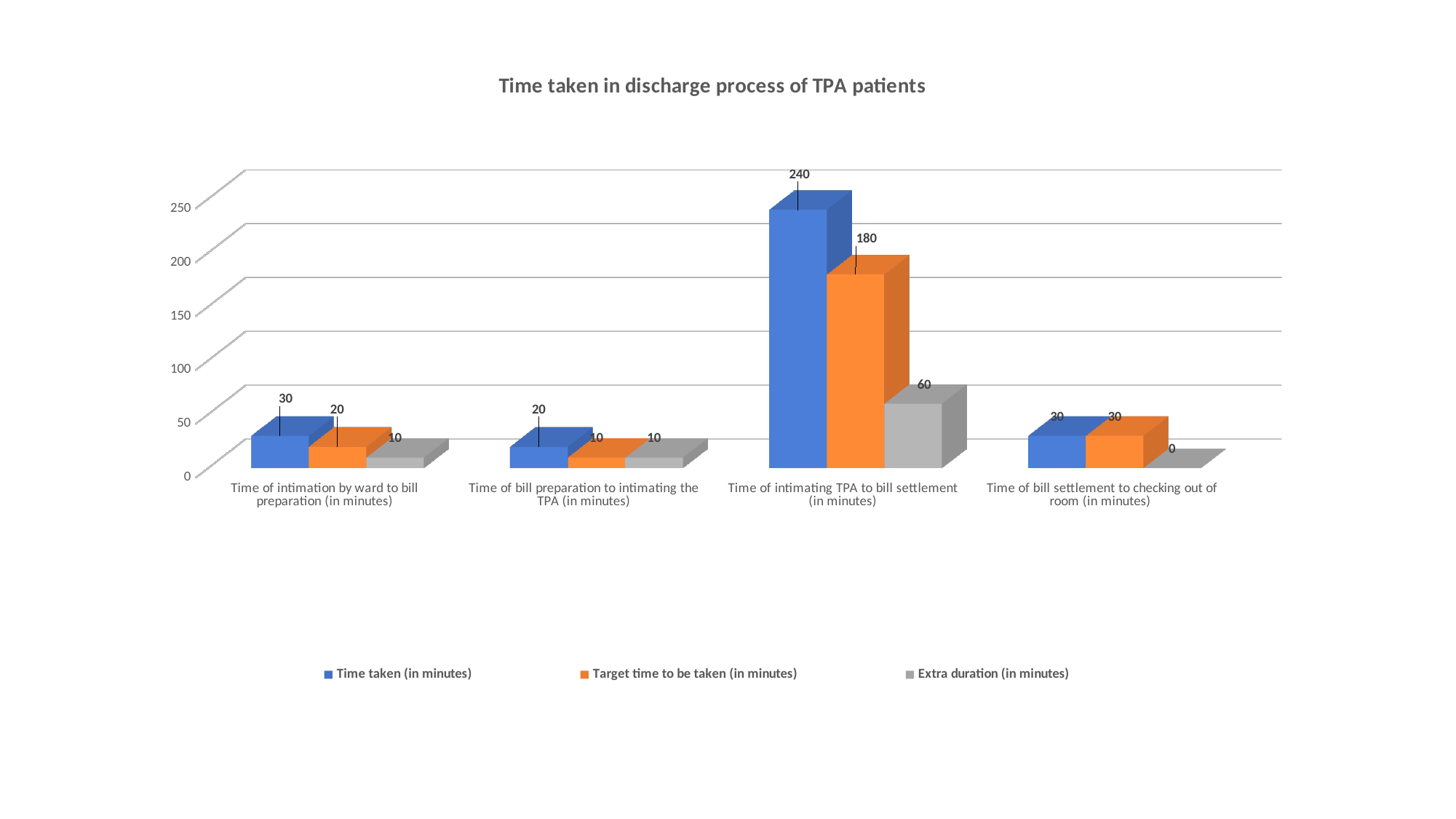
What is the difference between Time taken and Target time to be taken for Time of intimating TPA to bill settlement? 60 Which is larger for Time of intimation by ward to bill preparation: Time taken or Target time to be taken? Time taken (in minutes) What is the Time taken (in minutes) for Time of intimation by ward to bill preparation? 30 What is the title of the chart? Time taken in discharge process of TPA patients What is the Extra duration (in minutes) for Time of bill settlement to checking out of room? 0 How many series does the legend list? 3 What is the Time taken (in minutes) for Time of intimating TPA to bill settlement? 240 Which category has the lowest Extra duration (in minutes)? Time of bill settlement to checking out of room (in minutes) How many categories are shown on the x axis? 4 Which category has the highest Time taken (in minutes)? Time of intimating TPA to bill settlement (in minutes) What is the Target time to be taken (in minutes) for Time of intimating TPA to bill settlement? 180 What kind of chart is shown on the slide? Bar chart